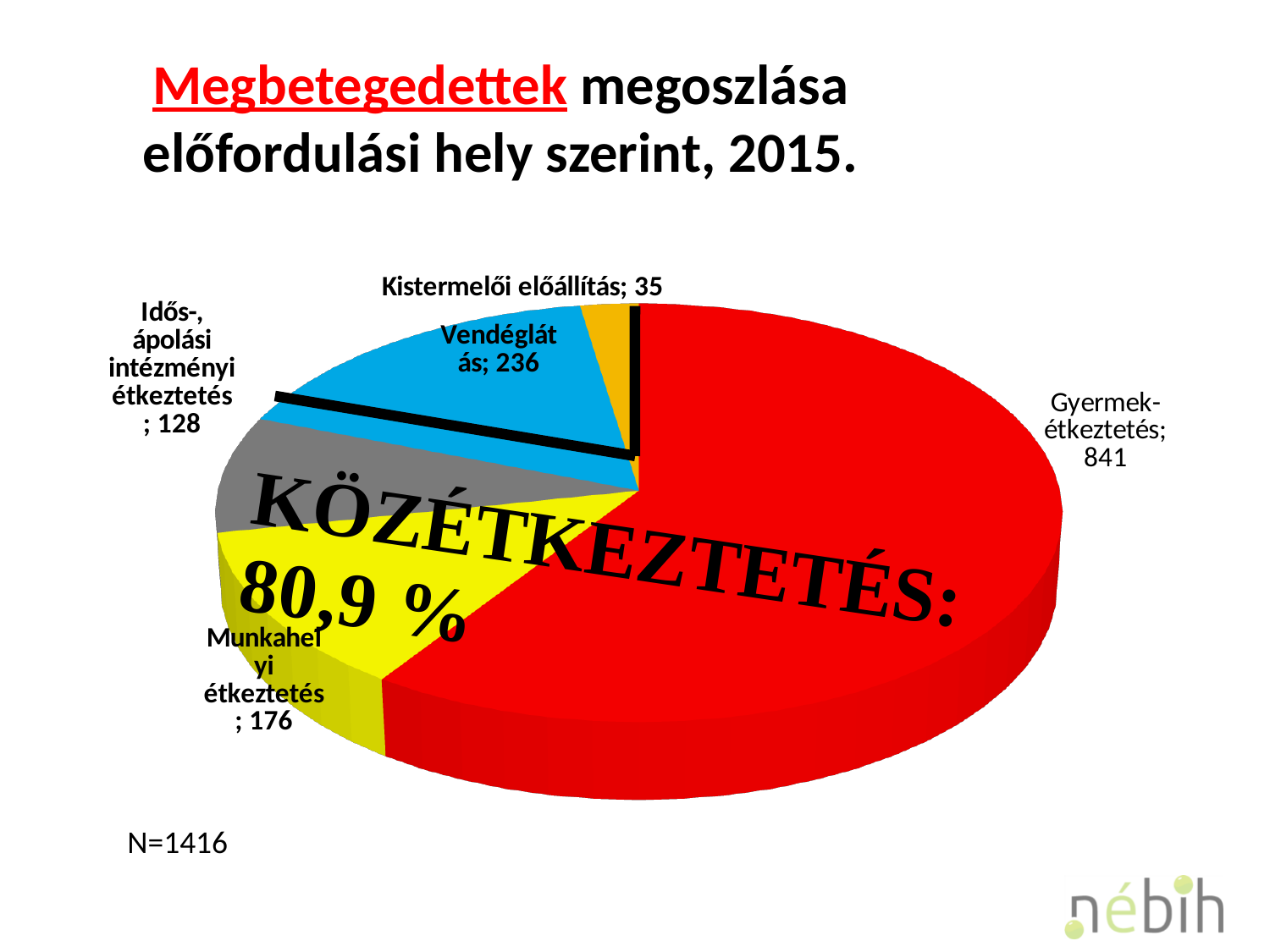
How many slices does the pie chart have? 5 Which is larger, Munkahelyi étkeztetés or Idős-, ápolási intézményi étkeztetés? Munkahelyi étkeztetés What is the value for Munkahelyi étkeztetés? 176 What is the value for Vendéglátás? 236 What total N is stated on the slide for the pie chart? N=1416 What is the value for Gyermekétkeztetés? 841 What is the difference between the values for Gyermekétkeztetés and Vendéglátás? 605 Which category has the largest slice? Gyermekétkeztetés Which category has the smallest slice? Kistermelői előállítás What is the value for Idős-, ápolási intézményi étkeztetés? 128 What type of chart is shown on the slide? pie chart What is the value for Kistermelői előállítás? 35